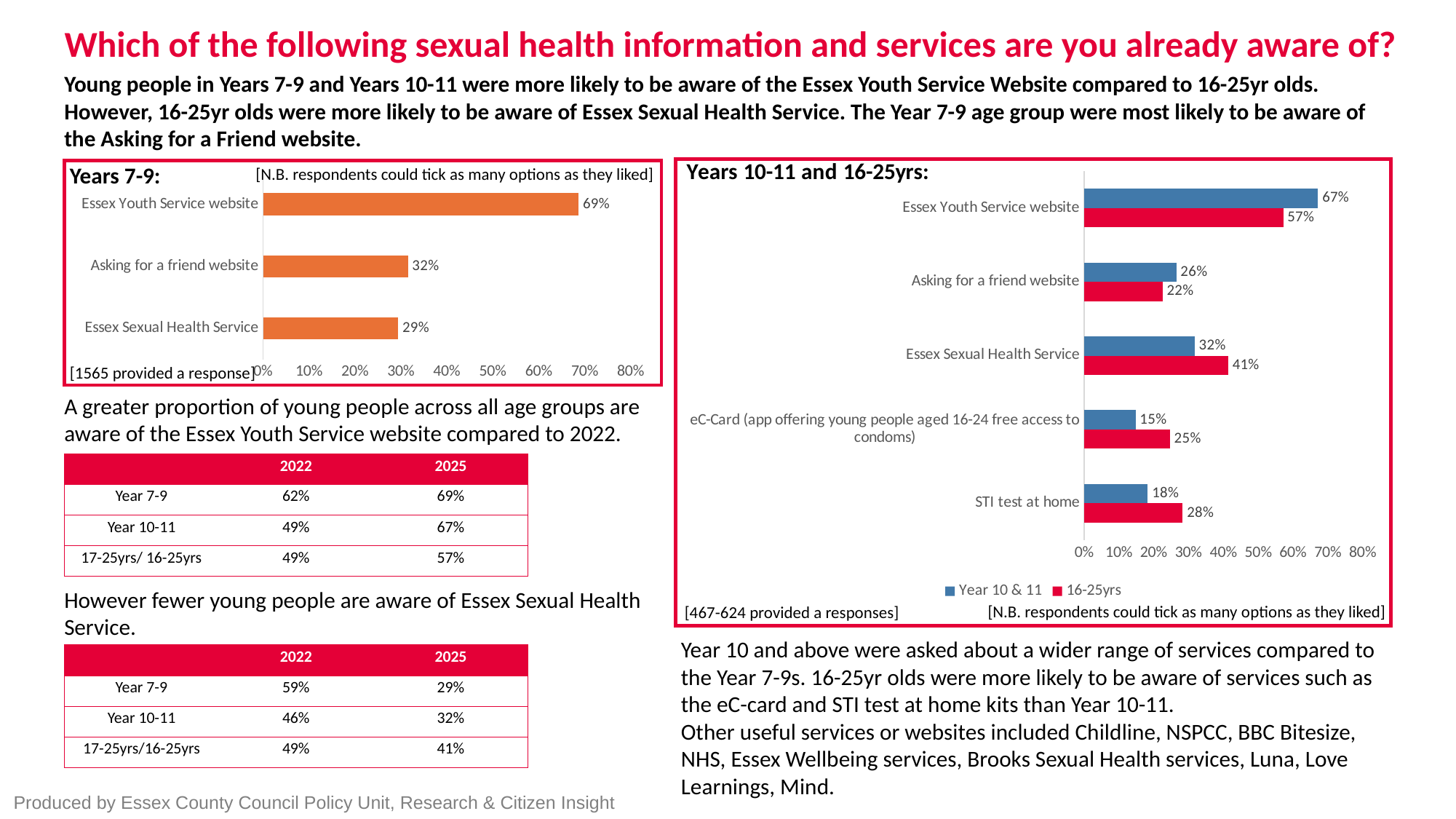
In the 'Years 7-9' chart, how many categories are shown? 3 In the 'Years 10-11 and 16-25yrs' chart, what percentage of 16-25yrs were aware of the Essex Sexual Health Service? 41% How many series does the legend of the 'Years 10-11 and 16-25yrs' chart list? 2 In the 'Years 10-11 and 16-25yrs' chart, what is the difference between Year 10 & 11 and 16-25yrs for STI test at home? 10% In the 'Years 7-9' chart, which service has the lowest awareness? Essex Sexual Health Service In the 'Years 10-11 and 16-25yrs' chart, what percentage of Year 10 & 11 were aware of the eC-Card? 15% In the 'Years 10-11 and 16-25yrs' chart, which category has the highest value for Year 10 & 11? Essex Youth Service website In the 'Years 7-9' chart, what percentage were aware of the Essex Youth Service website? 69% What type of chart is the 'Years 7-9' chart? Bar chart In the 'Years 10-11 and 16-25yrs' chart, how many categories are shown? 5 In the 'Years 7-9' chart, what is the difference between awareness of the Asking for a friend website and Essex Sexual Health Service? 3% In the 'Years 10-11 and 16-25yrs' chart, which group has the larger value for the Asking for a friend website? Year 10 & 11